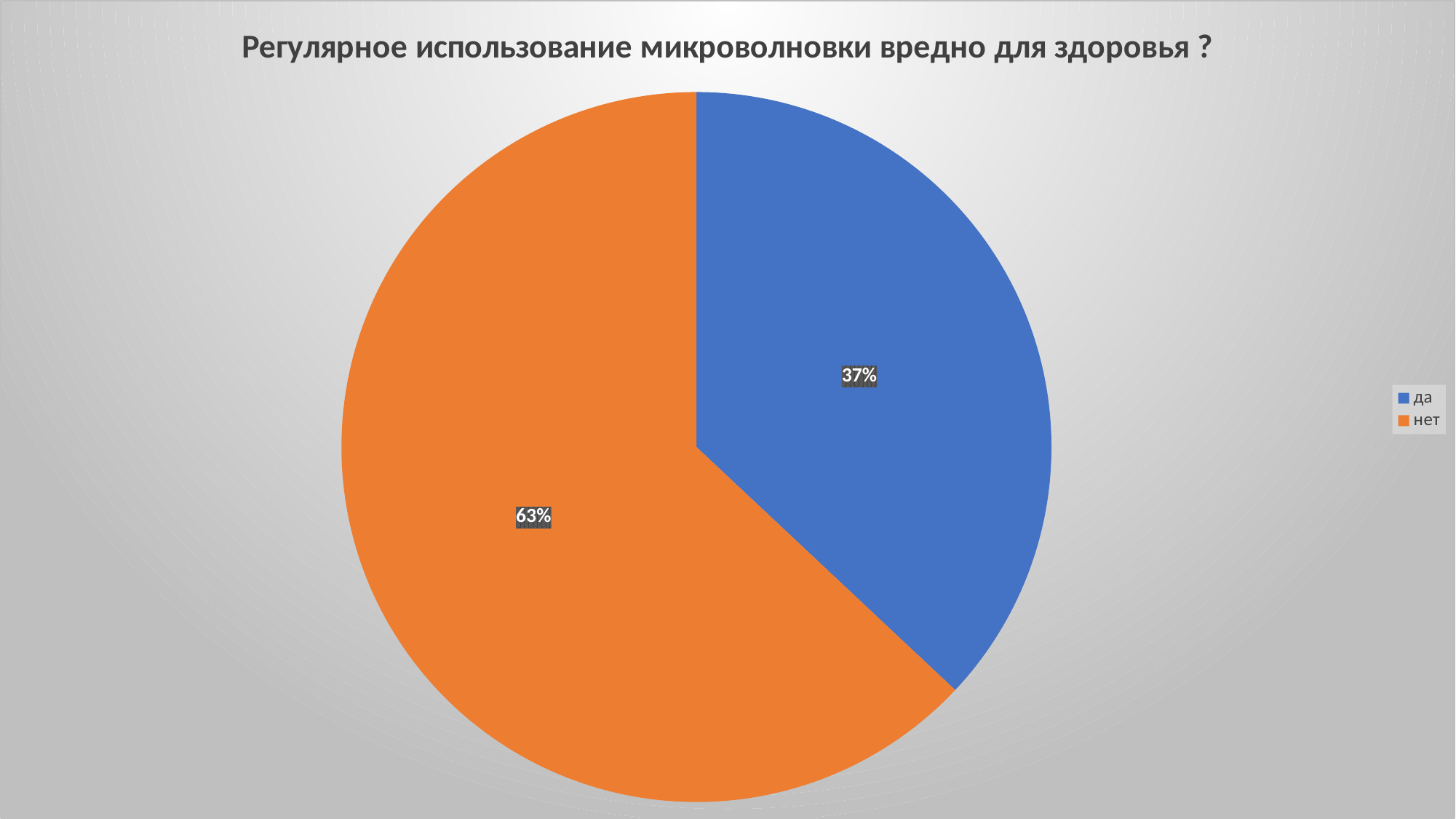
What percentage of the pie is labelled "да"? 37% How many entries does the legend list? 2 What is the difference in percentage points between the "нет" and "да" slices? 26 What share of the pie does the "да" slice represent? 37% What is the title of the chart? Регулярное использование микроволновки вредно для здоровья ? What type of chart is shown on the slide? pie chart Which category has the largest share of the pie? нет How many slices does the pie chart have? 2 Which category has the smallest share of the pie? да What percentage of the pie is labelled "нет"? 63% What colour is the "нет" slice? orange Which is larger, the share for "да" or the share for "нет"? нет